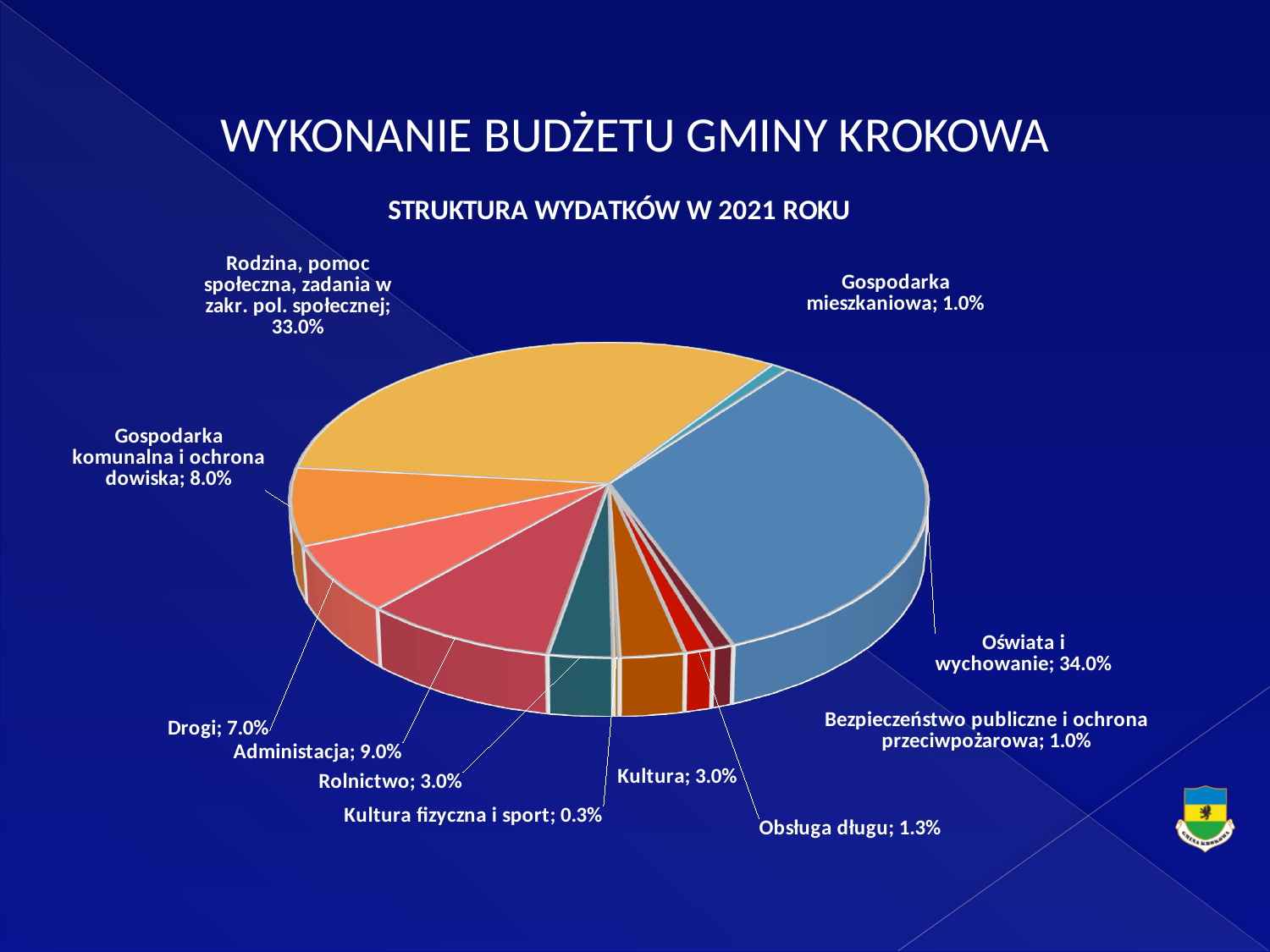
What is the share for Oświata i wychowanie? 34.0% What is the difference in percentage points between Oświata i wychowanie and Rodzina, pomoc społeczna, zadania w zakr. pol. społecznej? 1.0 percentage points What type of chart is shown on the slide? Pie chart What is the share for Obsługa długu? 1.3% Which has a larger share: Drogi or Gospodarka komunalna i ochrona środowiska? Gospodarka komunalna i ochrona środowiska Which category has the smallest share of the pie? Kultura fizyczna i sport What is the title of the chart? STRUKTURA WYDATKÓW W 2021 ROKU What is the share for Kultura fizyczna i sport? 0.3% What is the combined share of Rolnictwo and Kultura? 6.0% What is the share for Administracja? 9.0% Which category has the largest share of the pie? Oświata i wychowanie How many categories are shown in the pie chart? 11